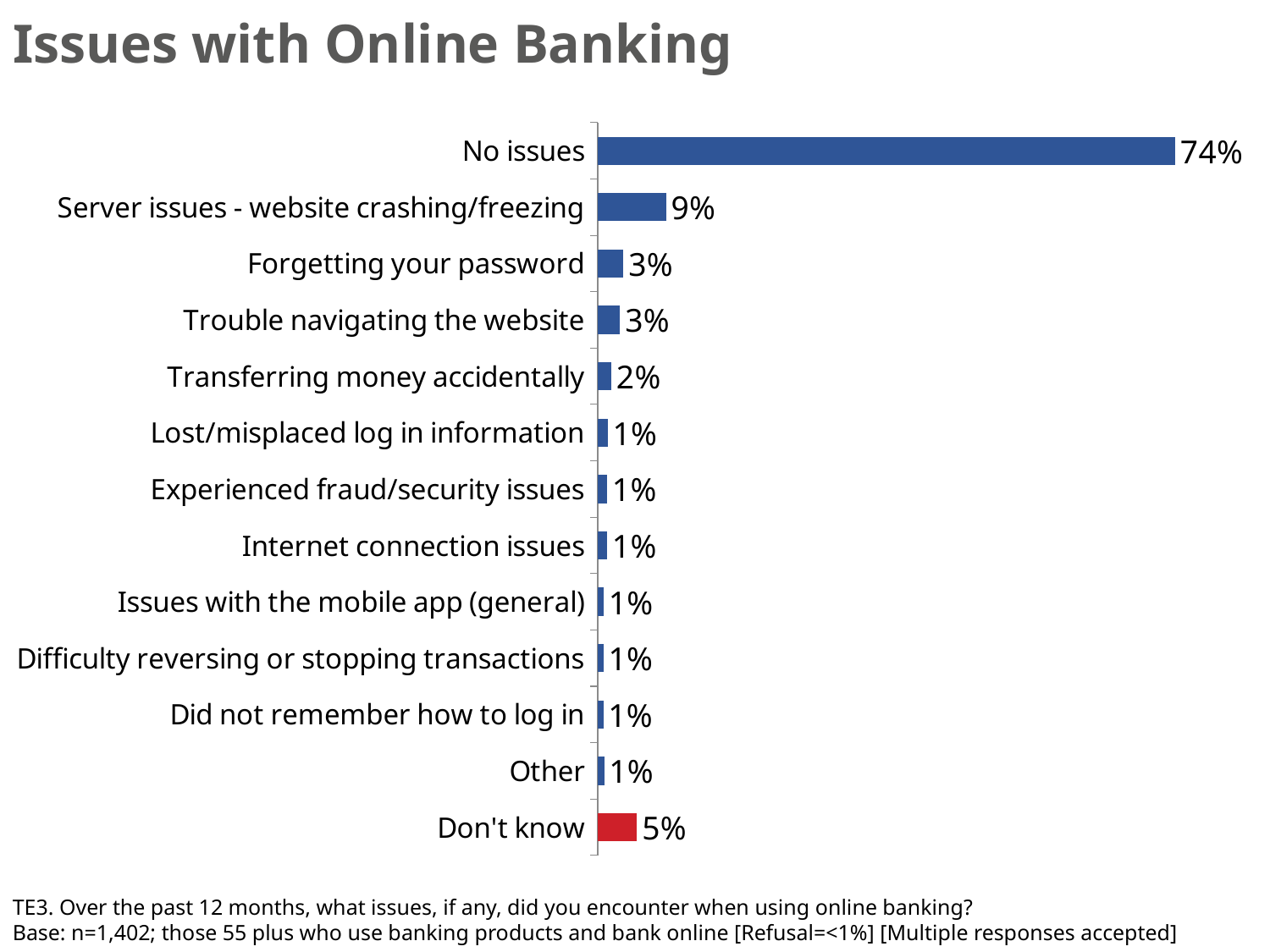
Which category has the highest value? No issues What is the value for 'Don't know'? 5% Which is larger: 'Server issues - website crashing/freezing' or 'Don't know'? Server issues - website crashing/freezing Which bar is shown in red rather than blue? Don't know What is the value for 'Server issues - website crashing/freezing'? 9% How many categories are shown in the chart? 13 What kind of chart is shown on the slide? Bar chart Which is larger: 'Forgetting your password' or 'Transferring money accidentally'? Forgetting your password What percentage of respondents reported no issues with online banking? 74% What is the difference between 'Don't know' and 'Forgetting your password'? 2% What is the difference between 'No issues' and 'Server issues - website crashing/freezing'? 65% What percentage reported 'Transferring money accidentally'? 2%